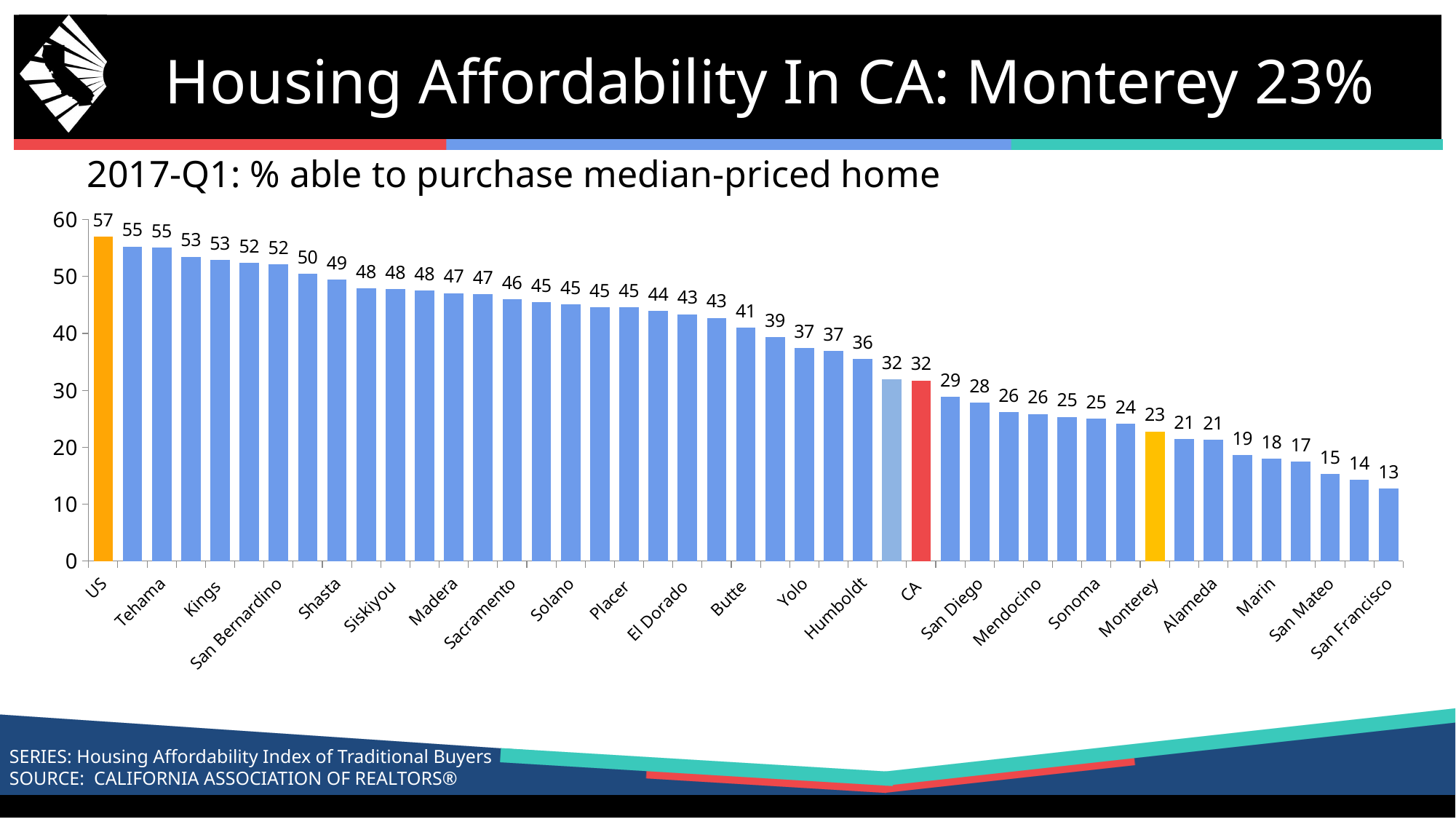
What is the value for US? 57 Which is larger, the value for Humboldt or the value for Sonoma? Humboldt Do the values generally rise or fall from left to right along the x axis? fall Which labeled category has the highest value? US What is the value for Sacramento? 46 Which labeled category has the lowest value? San Francisco What is the subtitle shown above the chart? 2017-Q1: % able to purchase median-priced home What is the value for CA? 32 What is the value for Monterey? 23 What is the difference between the values for CA and Monterey? 9 What kind of chart is shown on the slide? bar chart What is the value for San Francisco? 13